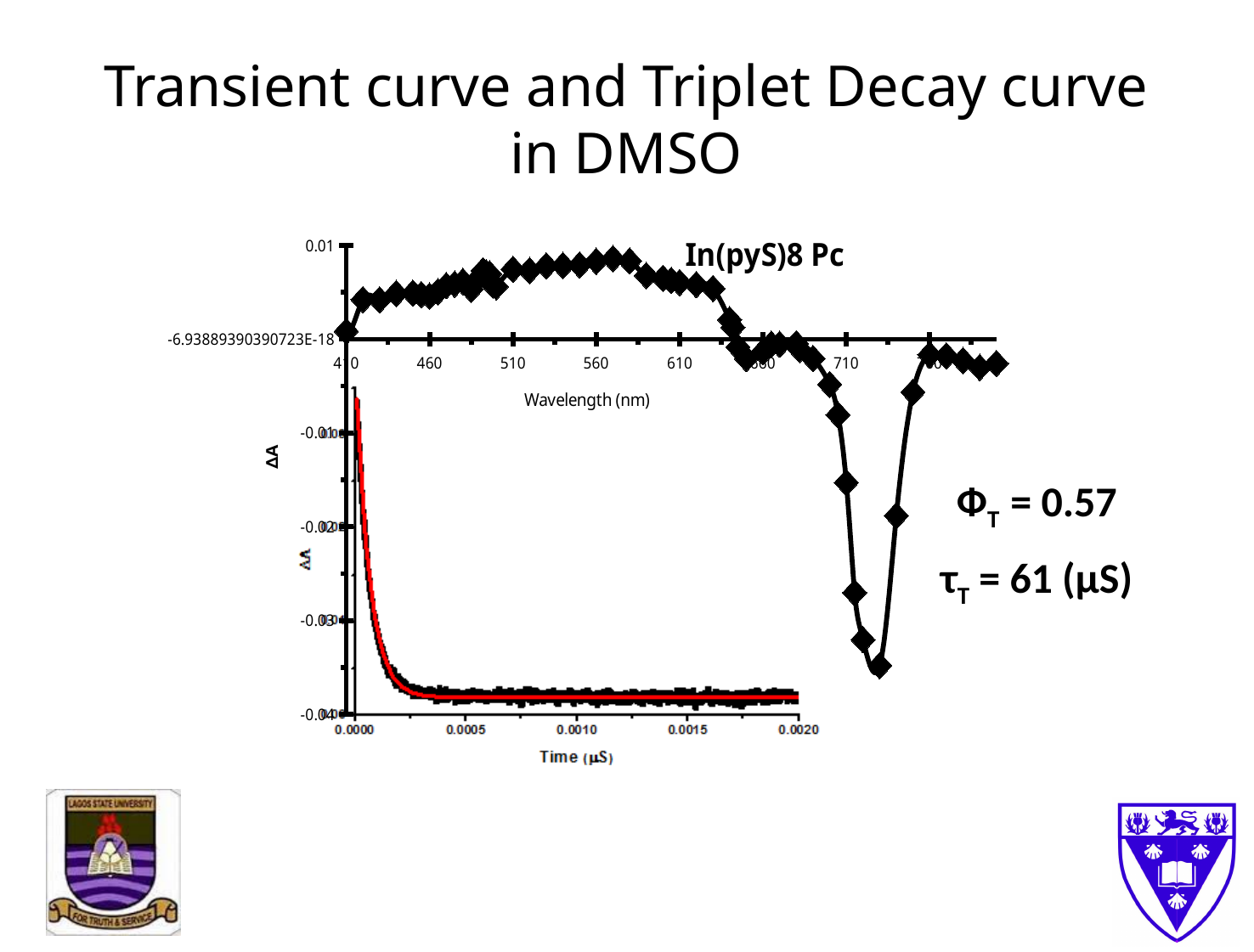
In the triplet decay curve chart, does the ΔA signal rise or fall as time increases from 0.0000 toward 0.0005 μS? fall In the transient curve chart, is the ΔA value at 460 nm greater or less than 0.01? less In the transient curve chart, is the ΔA value at 560 nm greater or less than 0? greater In the transient curve chart, is the ΔA value at 710 nm greater or less than 0? less What is the x-axis label of the triplet decay curve chart? Time (μS) What is the x-axis label of the transient curve chart? Wavelength (nm) What kind of chart is the transient curve (ΔA versus wavelength) on the slide? line chart In the transient curve chart, what compound name is written next to the plotted series? In(pyS)8 Pc What is the highest tick value shown on the time axis of the triplet decay curve chart? 0.0020 In the transient curve chart, which is larger: the ΔA value at 560 nm or the ΔA value at 710 nm? 560 nm What is the lowest tick value shown on the ΔA axis of the charts? -0.04